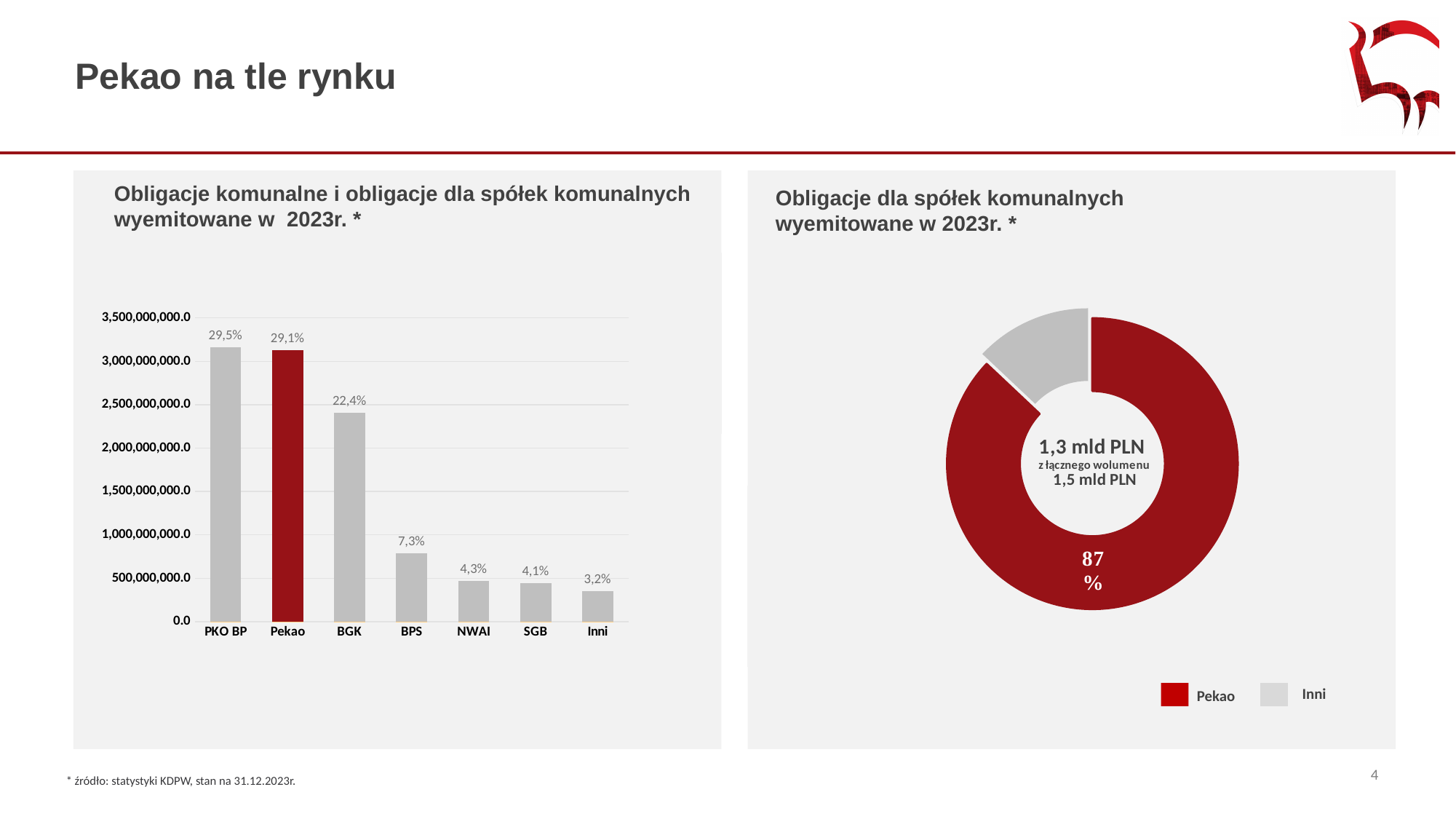
On the right chart, how many entries does the legend list? 2 On the left chart, which is larger, the value for BPS or the value for SGB? BPS On the right chart (Obligacje dla spółek komunalnych wyemitowane w 2023r.), what share of the donut belongs to Pekao? 87% On the left chart, which category has the lowest bar? Inni On the left chart, do the bar values rise or fall from left to right along the x axis? fall On the left chart, what percentage label is shown for BGK? 22,4% On the left chart, what percentage label is shown for NWAI? 4,3% On the left chart, what is the difference in percentage points between the labels for PKO BP and Pekao? 0,4 percentage points On the left chart, is the value for Pekao greater or less than 3,000,000,000.0? greater On the left chart, which category has the highest bar? PKO BP On the left chart, how many categories are shown on the x axis? 7 On the left chart (Obligacje komunalne i obligacje dla spółek komunalnych wyemitowane w 2023r.), what percentage label is shown for Pekao? 29,1%